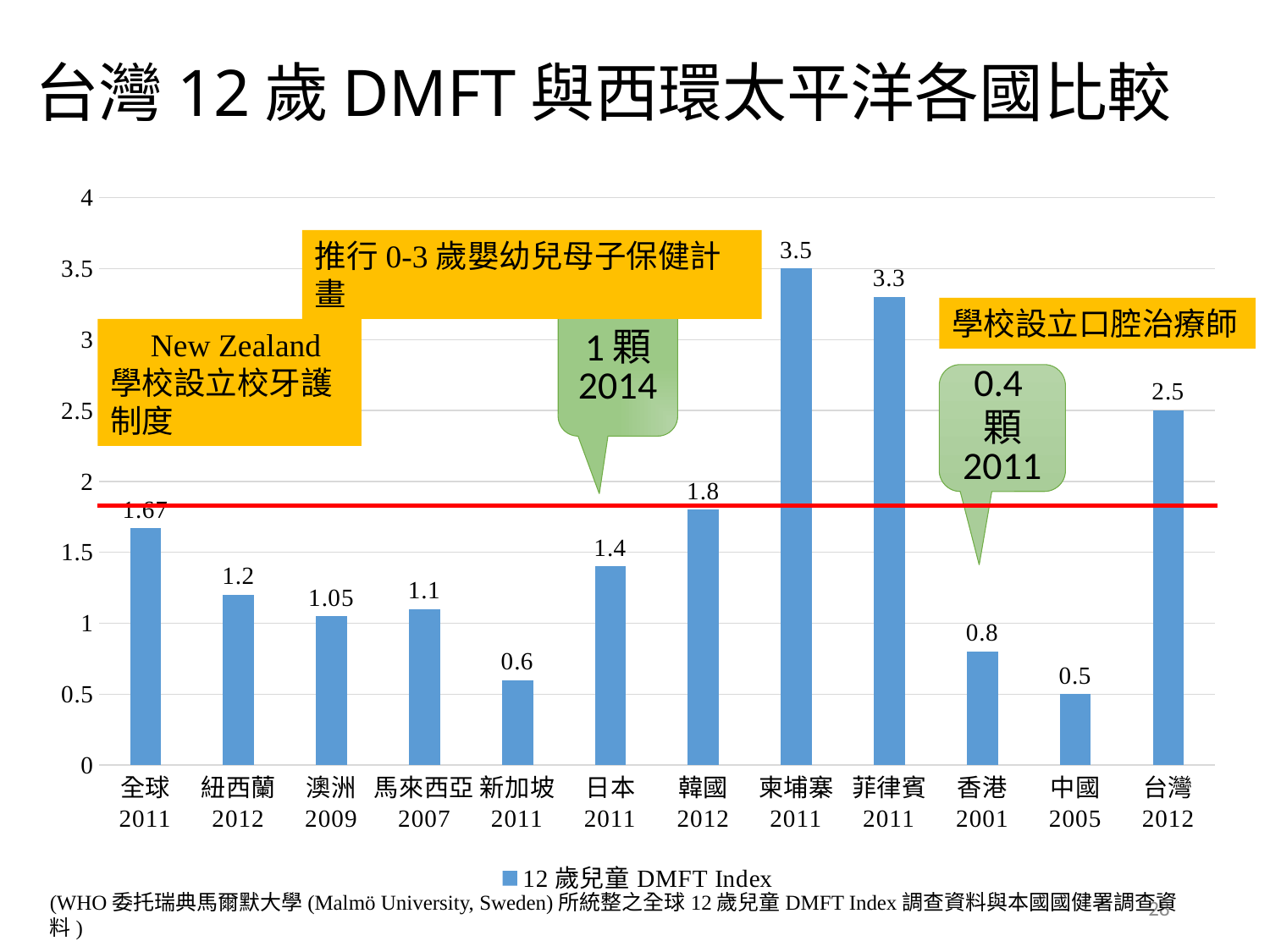
What is the DMFT value shown for 新加坡 2011? 0.6 What kind of chart is shown on the slide? bar chart Is the value for 香港 2001 greater or less than 1? less Which has a larger DMFT value, 日本 2011 or 紐西蘭 2012? 日本 2011 What is the difference between the DMFT values for 柬埔寨 2011 and 菲律賓 2011? 0.2 Which category has the lowest DMFT value? 中國 2005 What is the DMFT value shown for 台灣 2012? 2.5 What is the DMFT value shown for 全球 2011? 1.67 What series name does the legend show? 12 歲兒童 DMFT Index Which category has the highest DMFT value? 柬埔寨 2011 What is the difference between the DMFT values for 台灣 2012 and 韓國 2012? 0.7 How many categories (bars) are shown in the chart? 12